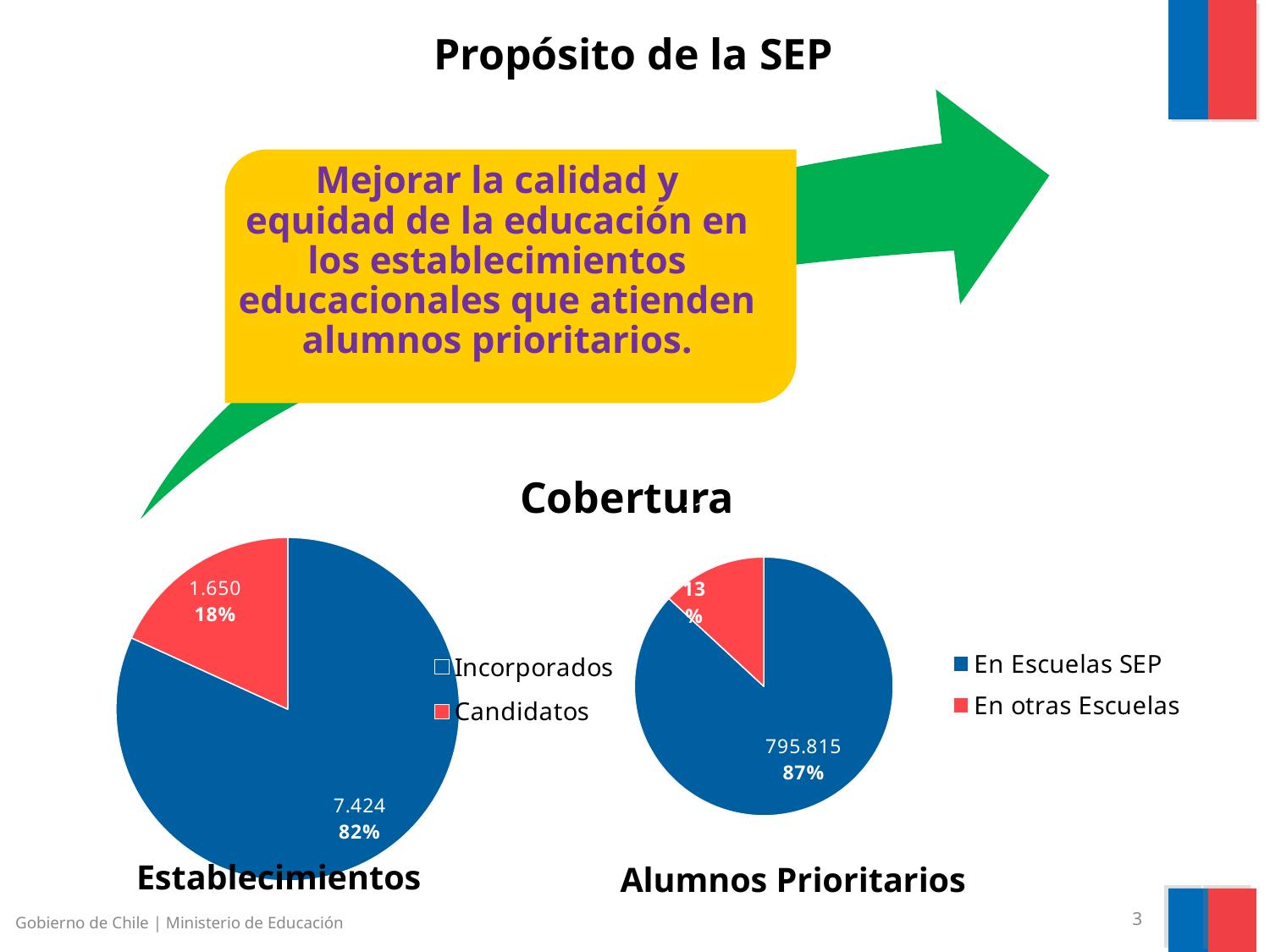
In the Establecimientos pie chart, what share of the pie is Candidatos? 18% In the Alumnos Prioritarios pie chart, which category is the smallest? En otras Escuelas How many entries does the legend of the Establecimientos chart list? 2 What kind of chart is the Alumnos Prioritarios chart? Pie chart In the Establecimientos pie chart, what is the value for Candidatos? 1.650 In the Establecimientos pie chart, which category is the largest? Incorporados In the Alumnos Prioritarios pie chart, what is the value for En Escuelas SEP? 795.815 In the Alumnos Prioritarios pie chart, what share of the pie is En otras Escuelas? 13% In the Establecimientos pie chart, what share of the pie is Incorporados? 82% In the Establecimientos pie chart, what is the difference between Incorporados and Candidatos? 5.774 In the Establecimientos pie chart, what is the value for Incorporados? 7.424